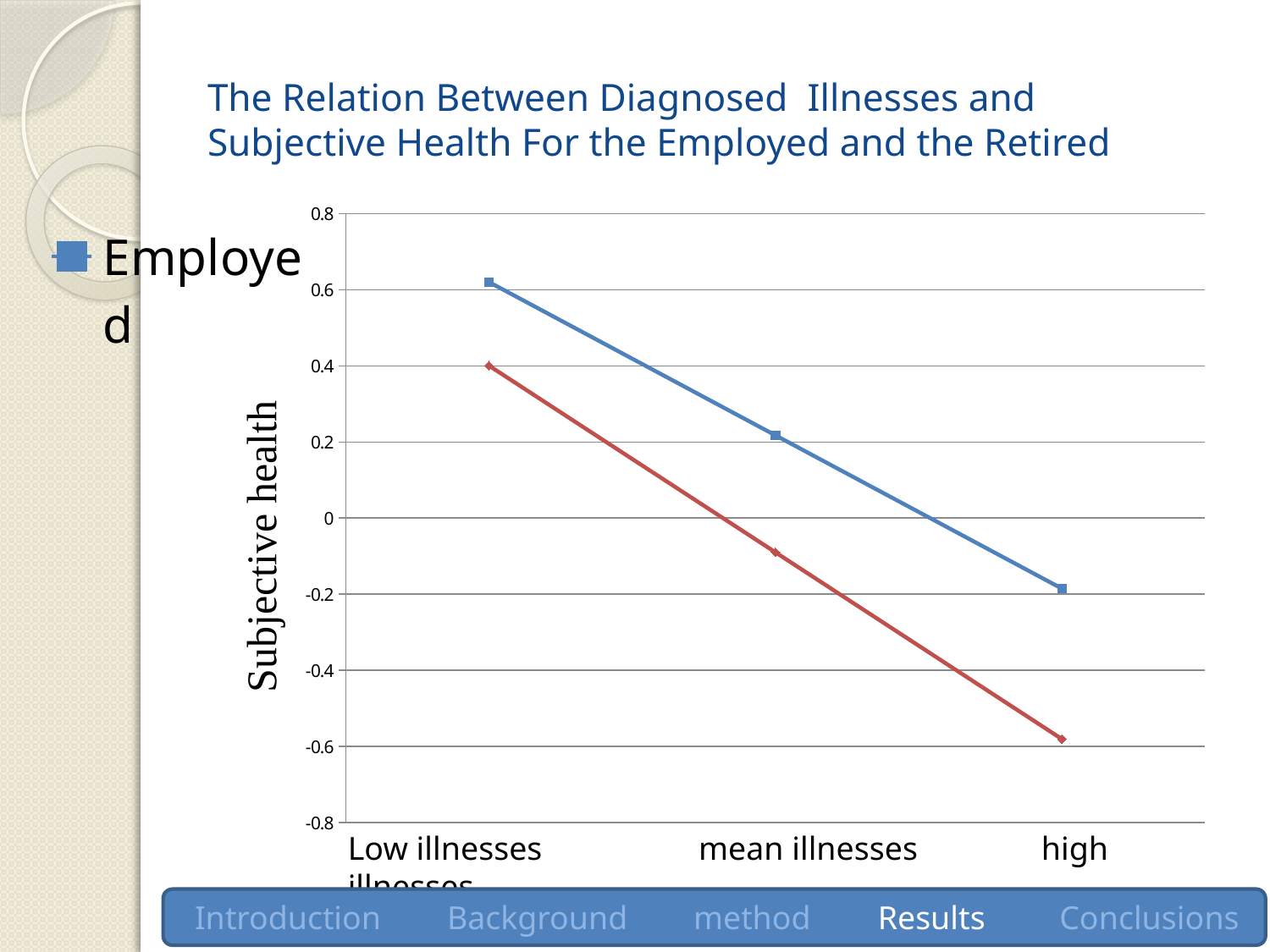
How many lines are plotted on the chart? 2 Is the value for Employed at mean illnesses greater or less than 0? greater How many categories are shown on the x axis of the chart? 3 Does the Employed line rise or fall from Low illnesses to high illnesses? fall Is the value of the red line at mean illnesses greater or less than 0.2? less Is the value for Employed at Low illnesses greater or less than 0.4? greater What is the title of the vertical axis of the chart? Subjective health For the Employed series, which category has the highest subjective health value? Low illnesses What kind of chart is shown on the slide? line chart At Low illnesses, which line is higher, the blue Employed line or the red line? the blue Employed line